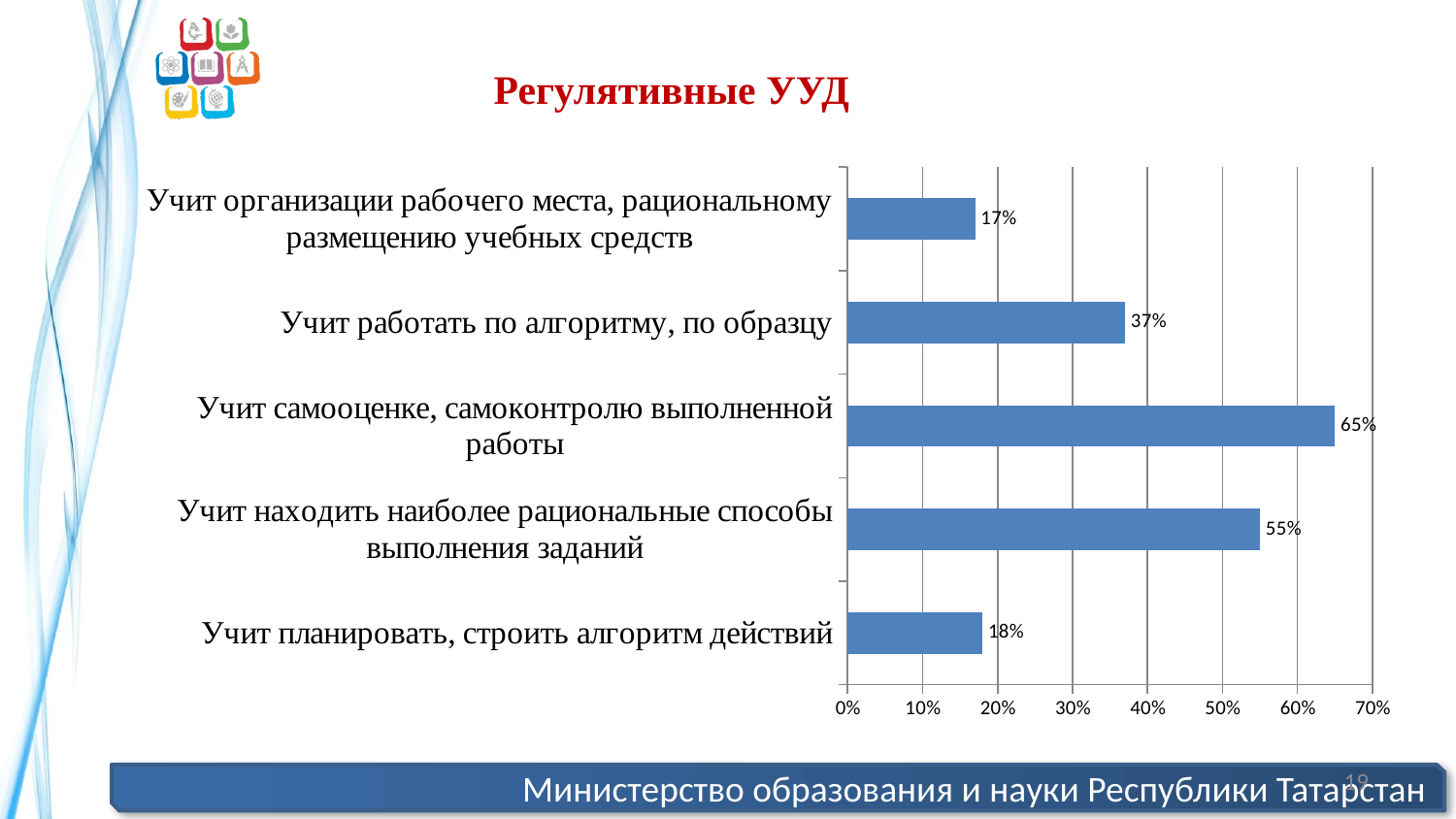
What is the value for 'Учит организации рабочего места, рациональному размещению учебных средств'? 17% How many categories are shown in the chart? 5 What kind of chart is shown on the slide? bar chart What is the difference between the values for 'Учит самооценке, самоконтролю выполненной работы' and 'Учит находить наиболее рациональные способы выполнения заданий'? 10% Which is larger: the value for 'Учит работать по алгоритму, по образцу' or for 'Учит планировать, строить алгоритм действий'? Учит работать по алгоритму, по образцу What is the value for 'Учит планировать, строить алгоритм действий'? 18% Which category has the highest value? Учит самооценке, самоконтролю выполненной работы Which category has the lowest value? Учит организации рабочего места, рациональному размещению учебных средств Is the value for 'Учит находить наиболее рациональные способы выполнения заданий' greater or less than 50%? greater What is the title of the slide containing the chart? Регулятивные УУД What is the value for 'Учит самооценке, самоконтролю выполненной работы'? 65% What is the value for 'Учит работать по алгоритму, по образцу'? 37%